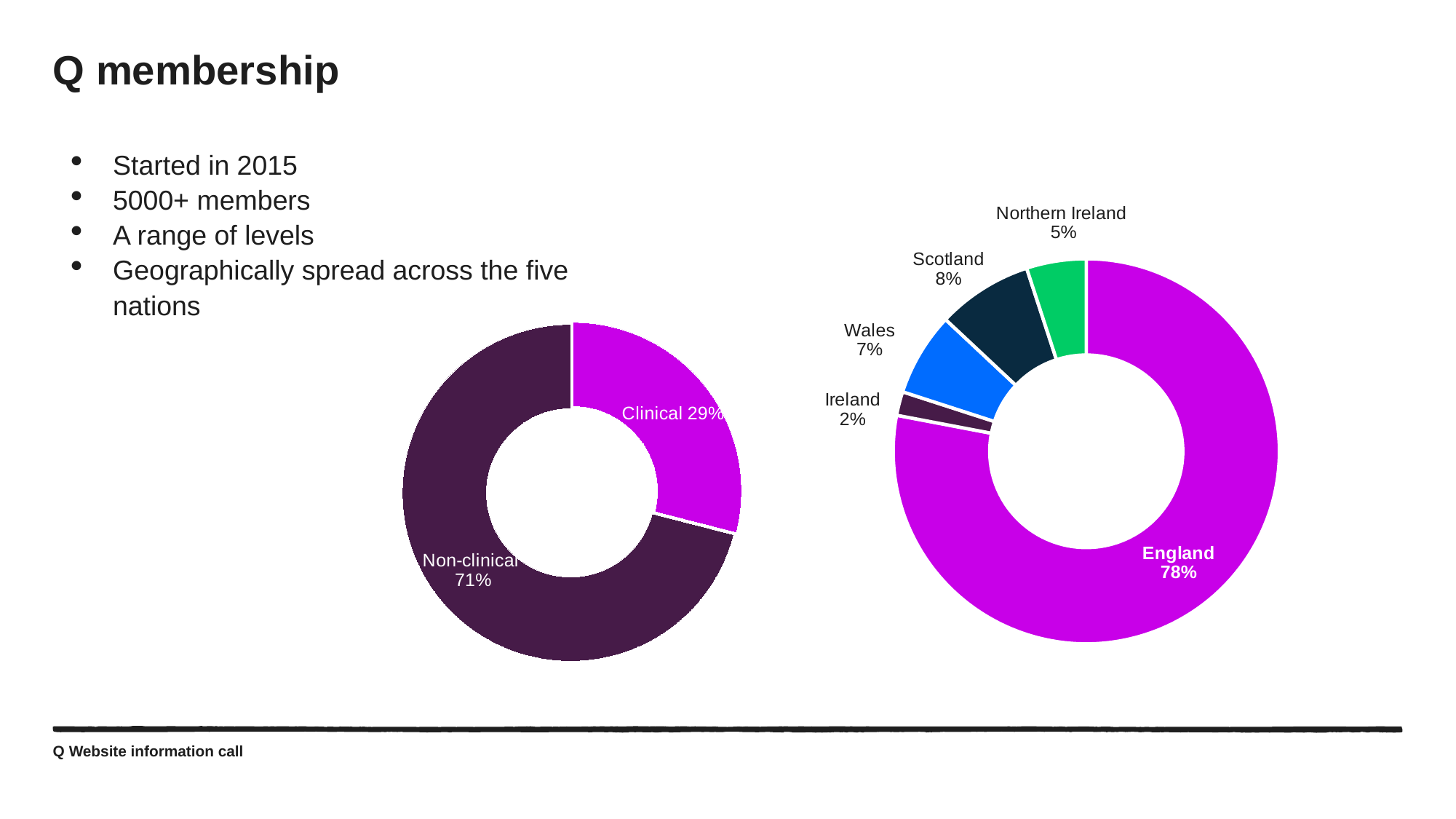
In the right doughnut chart, what share of members is in England? 78% In the right doughnut chart, which is larger, the share for Wales or the share for Northern Ireland? Wales In the left doughnut chart, what share of members is Clinical? 29% How many slices does the left doughnut chart have? 2 In the right doughnut chart, what is the difference between the Scotland and Ireland shares? 6 percentage points In the left doughnut chart, what share of members is Non-clinical? 71% In the right doughnut chart, what share of members is in Scotland? 8% In the left doughnut chart, what is the difference between the Non-clinical and Clinical shares? 42 percentage points In the left doughnut chart, which category has the larger share? Non-clinical What type of chart is used on the right side of the slide? Doughnut (pie) chart How many nations are shown in the right doughnut chart? 5 In the right doughnut chart, which nation has the smallest share? Ireland